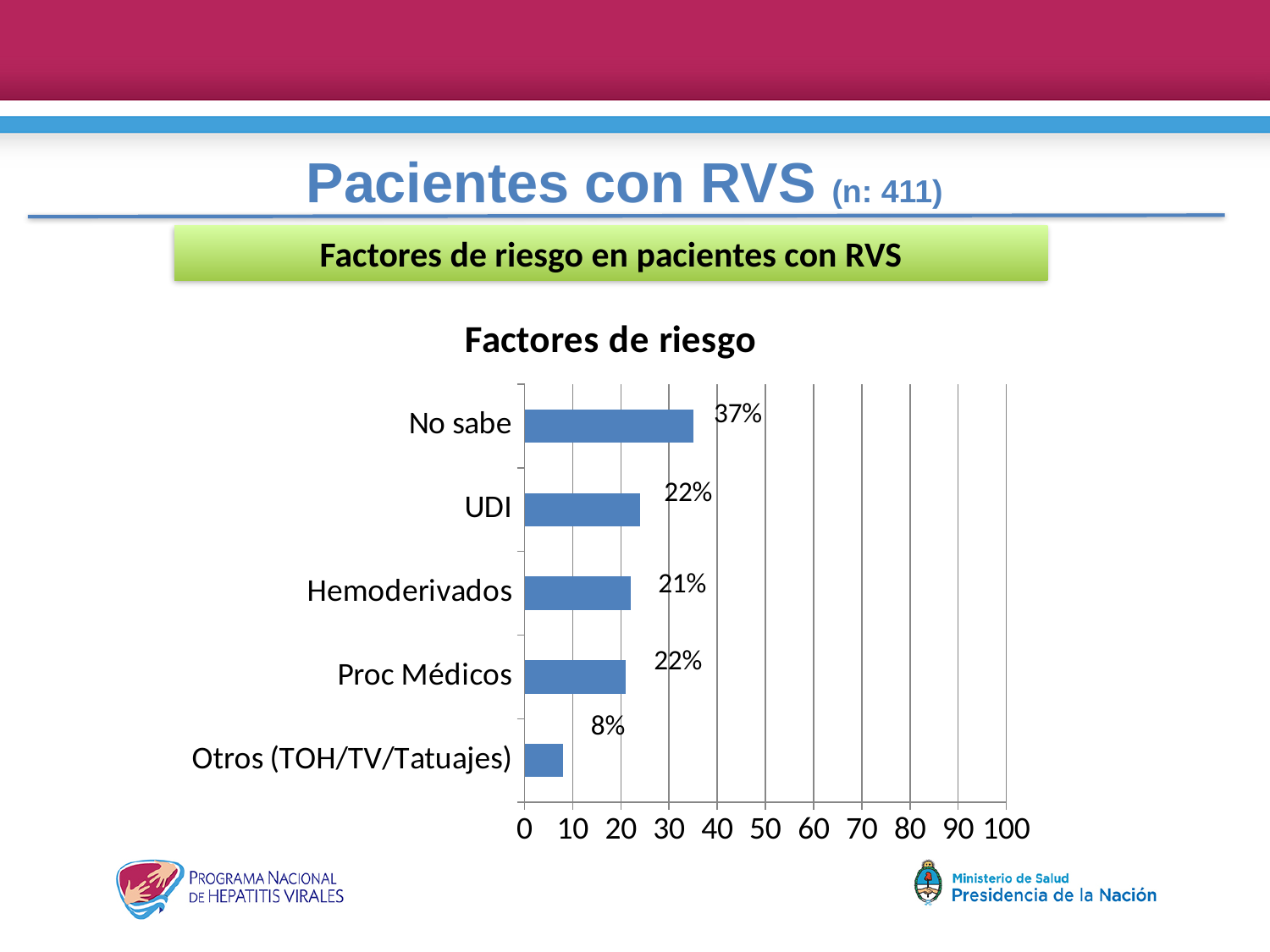
What is the difference between the values for No sabe and UDI? 15% Which is larger, the value for Proc Médicos or the value for Otros (TOH/TV/Tatuajes)? Proc Médicos What is the value for Otros (TOH/TV/Tatuajes) in the Factores de riesgo chart? 8% Is the value for No sabe greater or less than 50? less What is the value for No sabe in the Factores de riesgo chart? 37% What is the difference between the values for No sabe and Otros (TOH/TV/Tatuajes)? 29% Which risk factor has the highest value in the Factores de riesgo chart? No sabe What kind of chart is the Factores de riesgo chart? bar chart Which risk factor has the lowest value in the Factores de riesgo chart? Otros (TOH/TV/Tatuajes) What is the value for UDI in the Factores de riesgo chart? 22% How many risk factor categories are shown in the Factores de riesgo chart? 5 What is the value for Hemoderivados in the Factores de riesgo chart? 21%